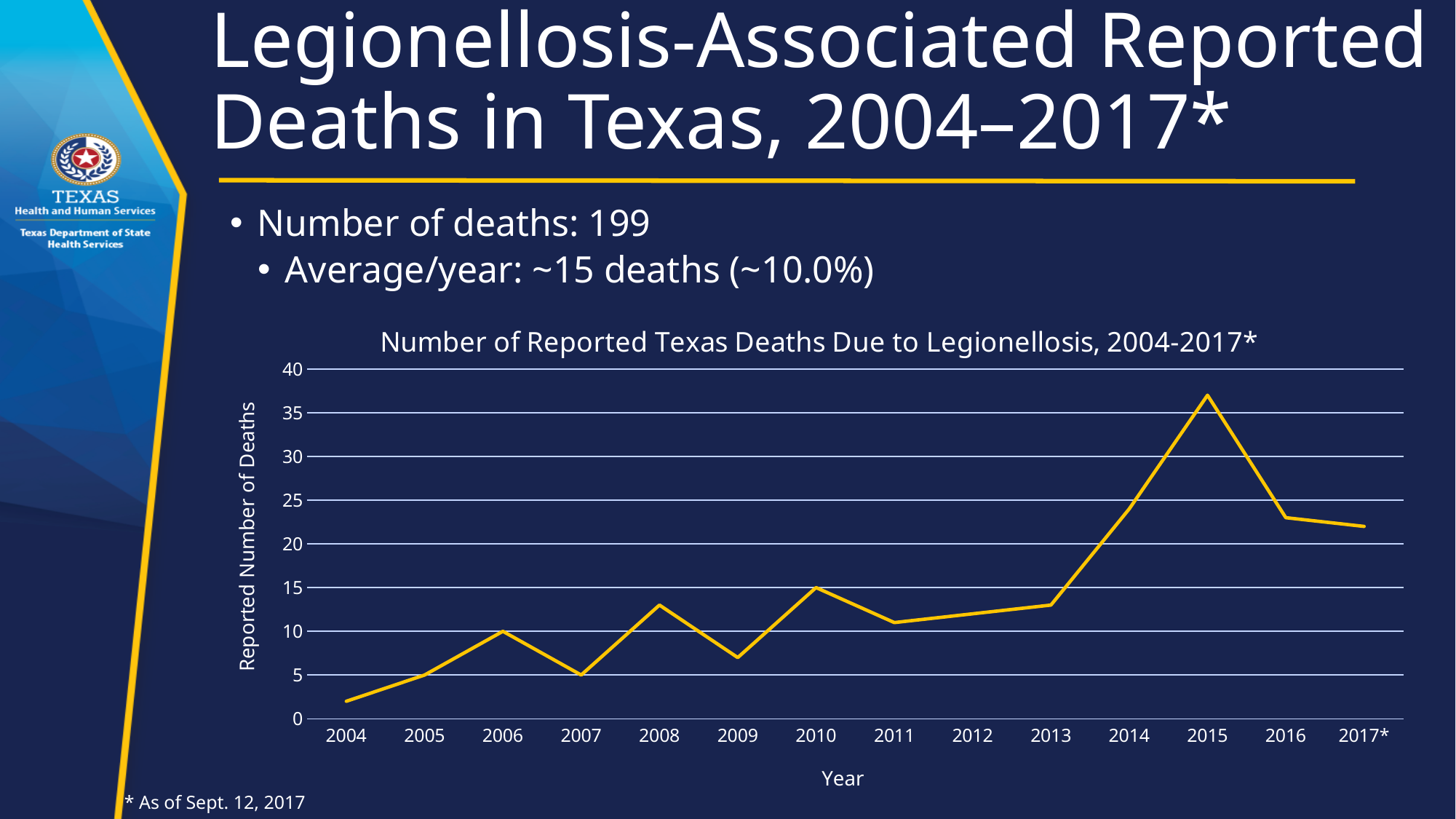
What is the label of the vertical axis of the chart? Reported Number of Deaths What kind of chart is shown on the slide? line chart Which year has the lowest number of reported deaths? 2004 What is the title of the chart? Number of Reported Texas Deaths Due to Legionellosis, 2004-2017* What is the reported number of deaths for 2006? 10 Is the value for 2004 greater or less than 5? less Is the value for 2015 greater or less than 35? greater Which year has the highest number of reported deaths? 2015 Which year has more reported deaths, 2008 or 2009? 2008 What is the reported number of deaths for 2010? 15 How many years are plotted along the x axis of the chart? 14 Do the reported deaths rise or fall from 2013 to 2015? rise